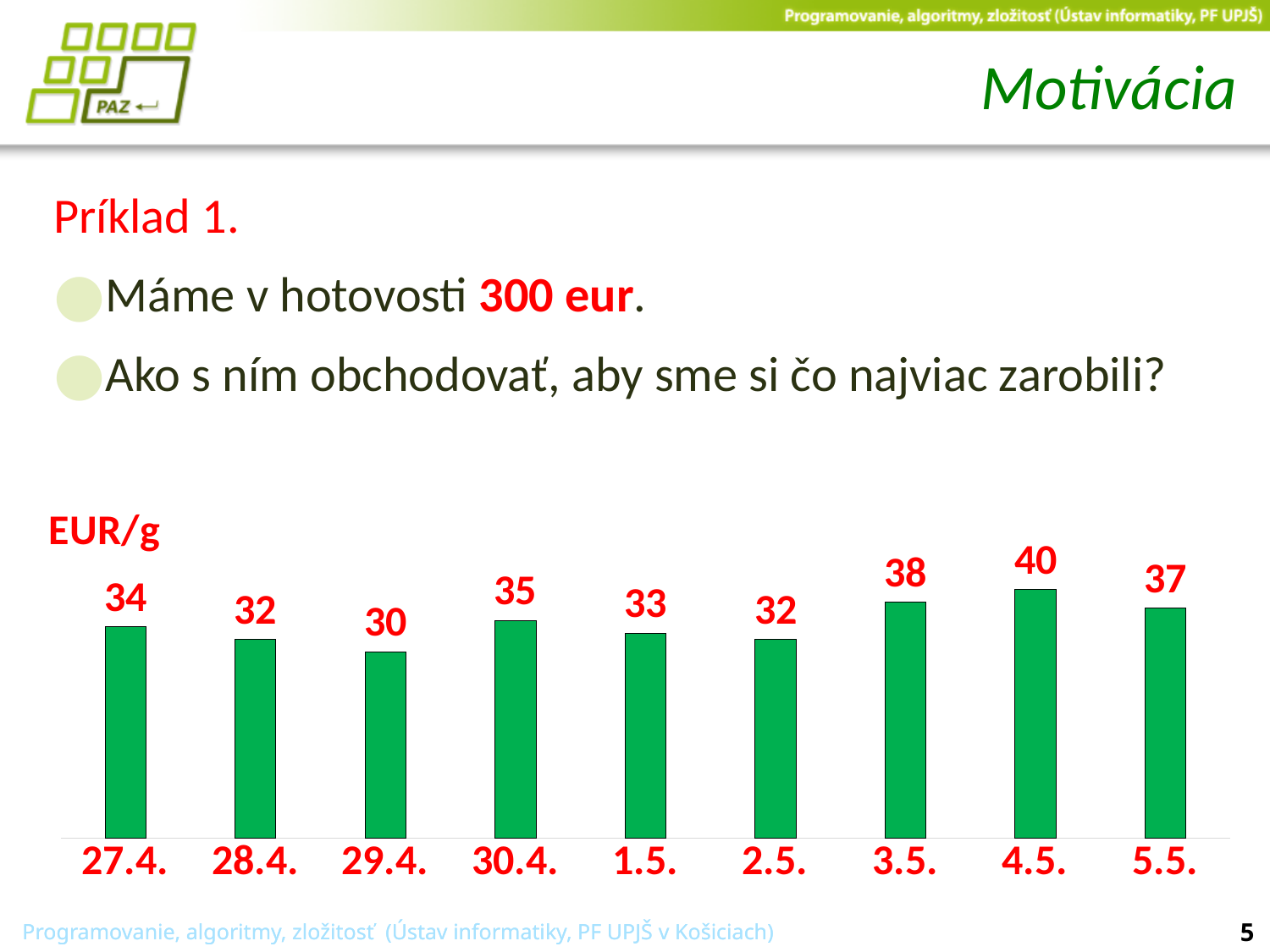
What is the value for 27.4.? 34 Which is larger, the value for 5.5. or the value for 3.5.? 3.5. What is the value for 29.4.? 30 What unit label is shown above the chart? EUR/g How many dates are shown on the x axis? 9 Do the values rise or fall from 1.5. to 4.5.? rise Which date has the lowest value? 29.4. What is the difference between the values for 30.4. and 1.5.? 2 What kind of chart is shown on the slide? bar chart Which date has the highest value? 4.5. What is the difference between the values for 4.5. and 29.4.? 10 What is the value for 3.5.? 38